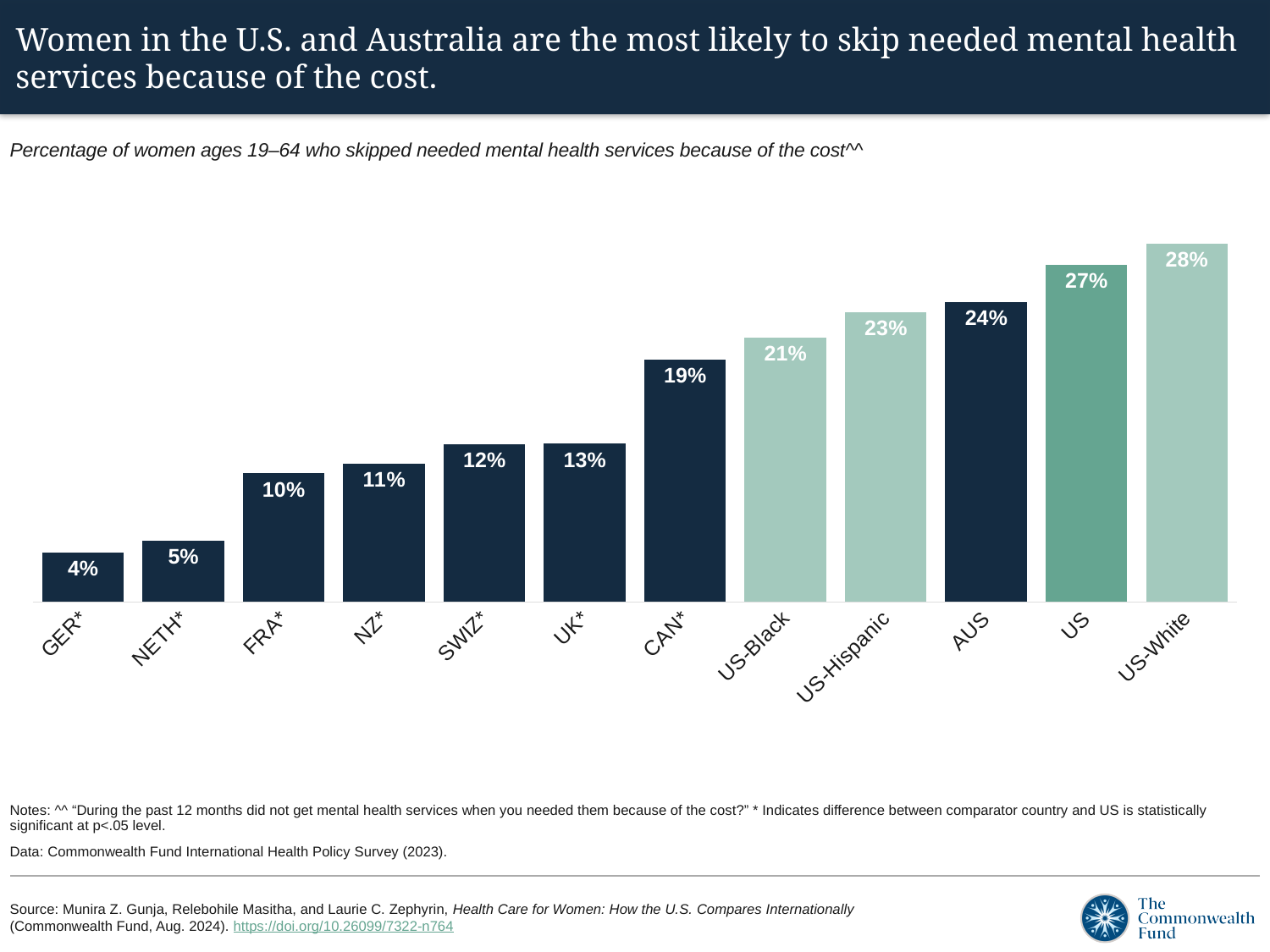
What is the subtitle describing the chart's measure? Percentage of women ages 19–64 who skipped needed mental health services because of the cost Which category has the lowest value? GER* What is the difference between the values for US-Hispanic and US-Black? 2% What is the difference between the values for US and GER*? 23% What is the value for AUS? 24% What is the value for CAN*? 19% Which category has the highest value? US-White Which is larger, the value for UK* or the value for NZ*? UK* What kind of chart is shown on the slide? Bar chart How many categories are shown on the x axis? 12 Do the values rise or fall from left to right along the x axis? Rise What is the value for US-White? 28%